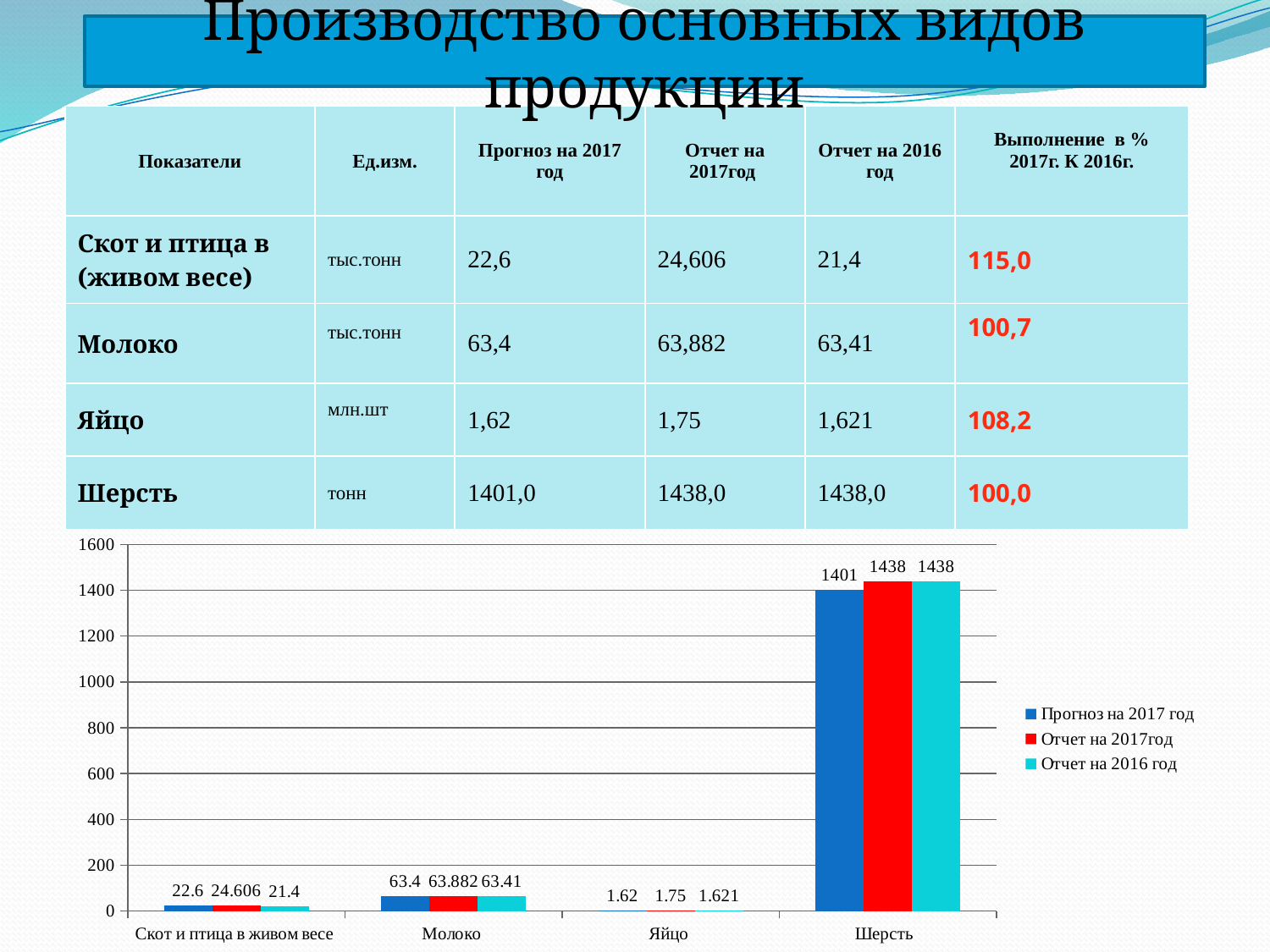
Which category has the lowest values in the chart? Яйцо What kind of chart is shown at the bottom of the slide? bar chart In the chart, which is larger for Скот и птица в живом весе: 'Прогноз на 2017 год' or 'Отчет на 2016 год'? Прогноз на 2017 год In the chart, what is the value of 'Прогноз на 2017 год' for Шерсть? 1401 How many series does the chart legend list? 3 How many categories are shown on the x axis of the chart? 4 In the chart, what is the value of 'Отчет на 2016 год' for Молоко? 63.41 In the chart, what is the value of 'Отчет на 2017год' for Яйцо? 1.75 Which colour represents 'Отчет на 2016 год' in the chart? cyan In the chart, what is the value of 'Отчет на 2017год' for Скот и птица в живом весе? 24.606 In the chart, what is the difference between 'Отчет на 2017год' and 'Прогноз на 2017 год' for Шерсть? 37 Which category has the highest values in the chart? Шерсть